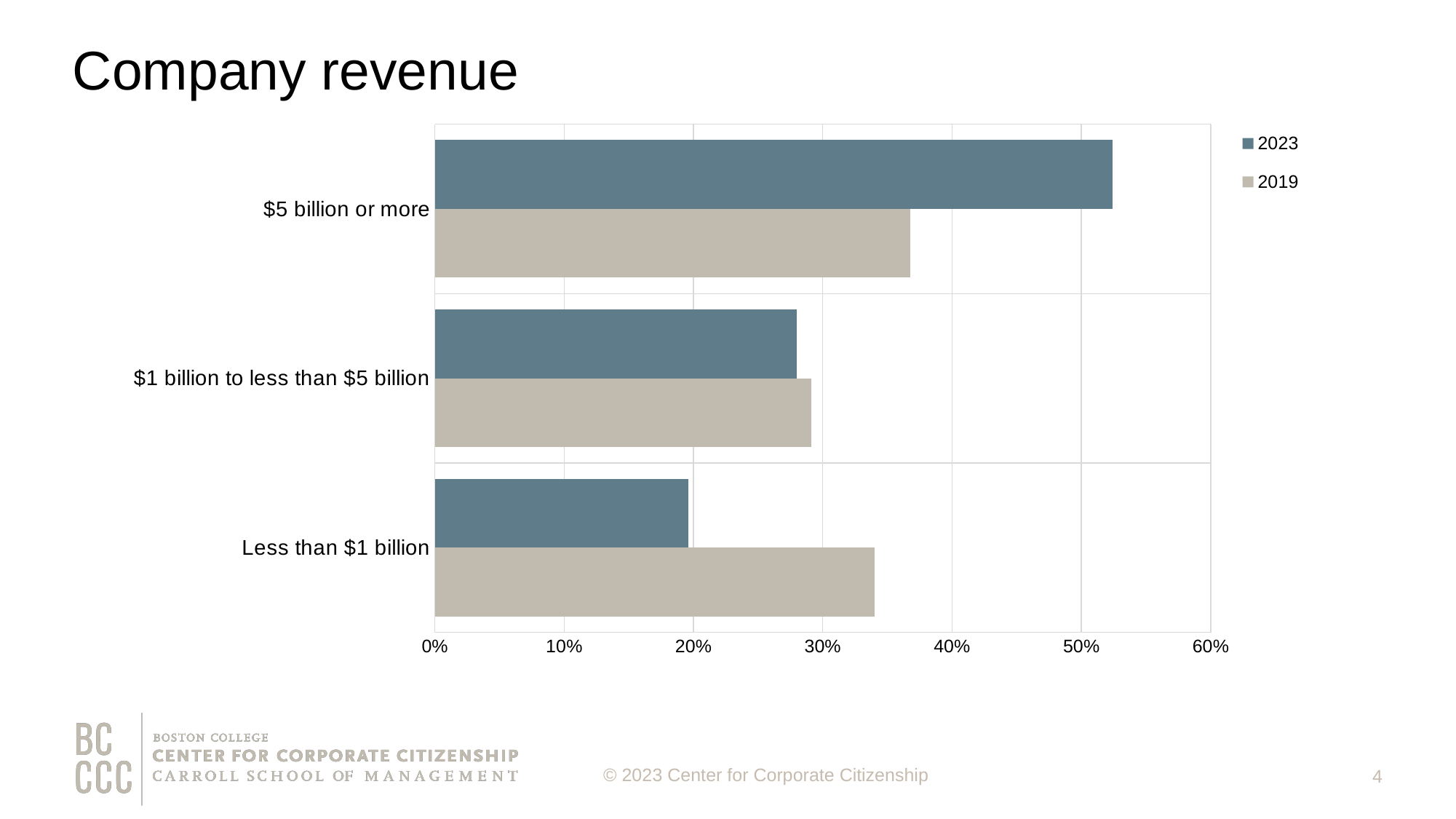
Is the 2019 value for "Less than $1 billion" greater or less than 30%? greater Which revenue category has the lowest value for 2019? $1 billion to less than $5 billion How many revenue categories are shown on the chart? 3 Is the 2019 value for "$5 billion or more" greater or less than 40%? less What type of chart is shown on the slide? bar chart Which revenue category has the lowest value for 2023? Less than $1 billion Which revenue category has the highest value for 2023? $5 billion or more What is the title of the chart on the slide? Company revenue Is the 2023 value for "$5 billion or more" greater or less than 50%? greater For "Less than $1 billion", which year has the larger value, 2023 or 2019? 2019 Which revenue category has the highest value for 2019? $5 billion or more How many series does the legend list? 2